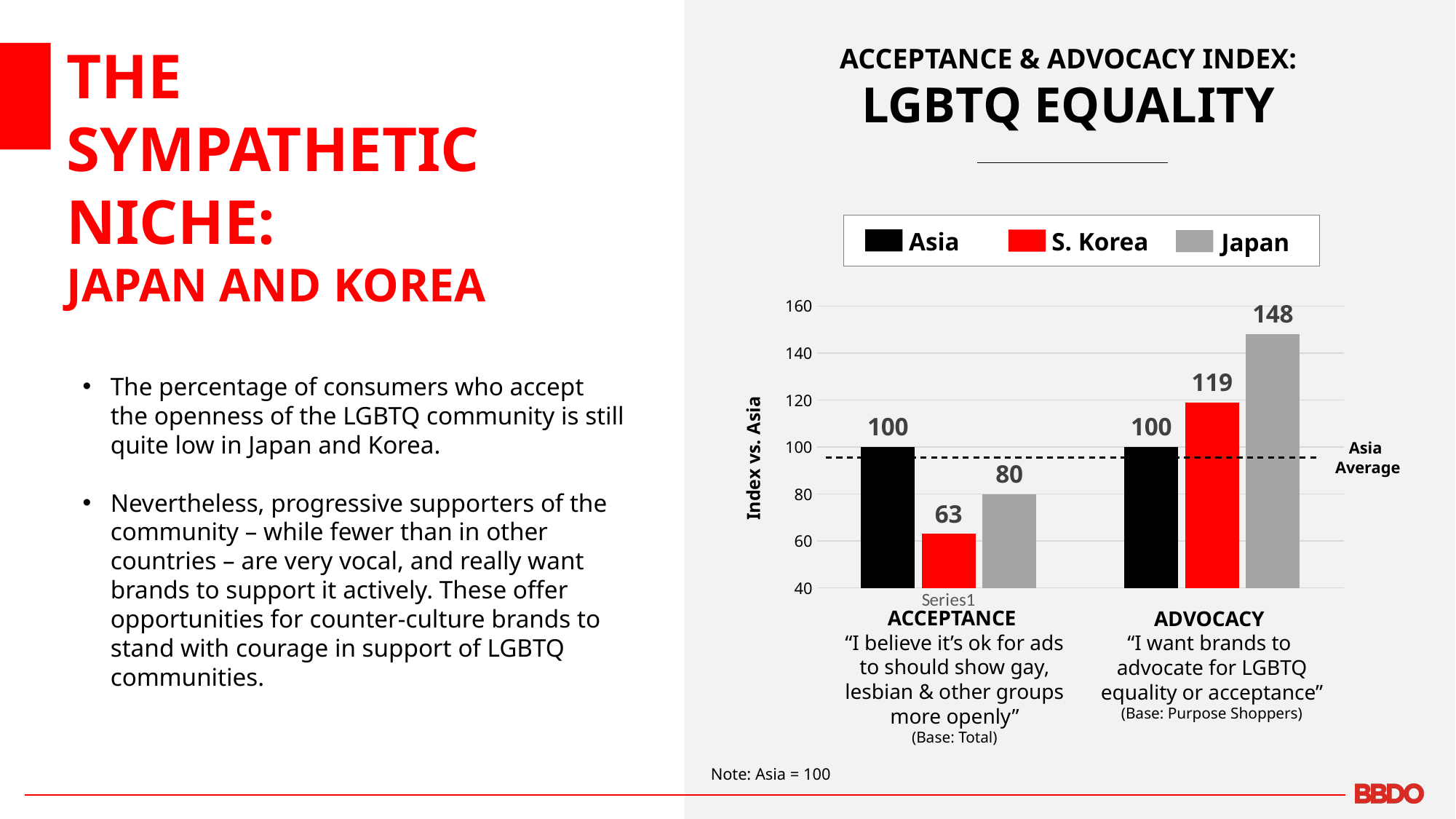
What kind of chart is shown on the slide? Bar chart Which is larger: the Japan value for Acceptance or the Japan value for Advocacy? Advocacy What is the label of the y axis? Index vs. Asia What is the Japan value for Acceptance? 80 Which series has the highest value for Advocacy? Japan How many series does the legend list? 3 Which series has the lowest value for Acceptance? S. Korea What is the Japan value for Advocacy? 148 What is the S. Korea value for Advocacy? 119 What is the S. Korea value for Acceptance? 63 What colour are the S. Korea bars? Red What is the difference between the Japan and S. Korea values for Advocacy? 29